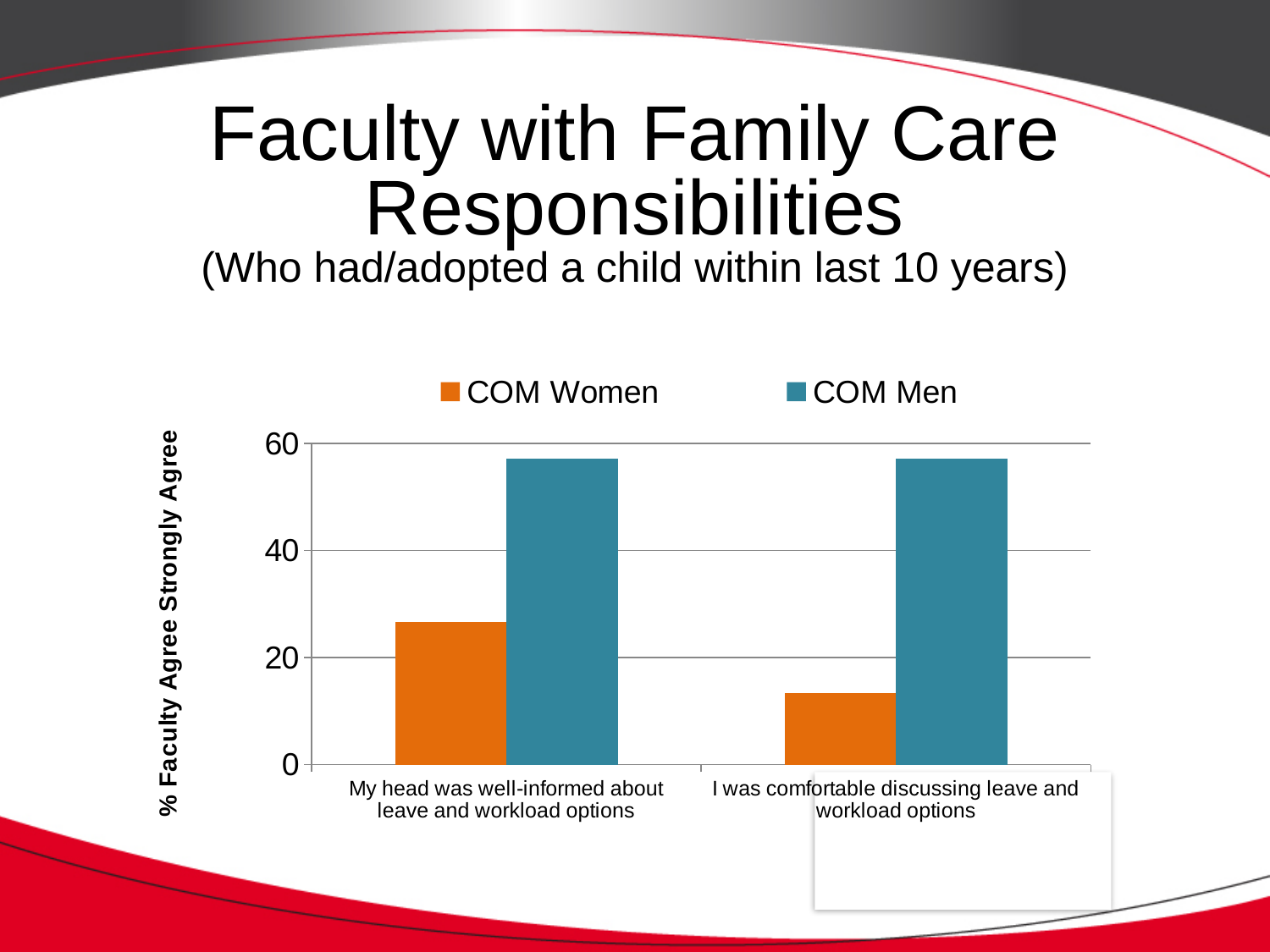
For COM Women, which category has the higher value? My head was well-informed about leave and workload options Which series has the larger value for "I was comfortable discussing leave and workload options", COM Women or COM Men? COM Men Which bar is the lowest in the chart? COM Women, I was comfortable discussing leave and workload options What kind of chart is shown on the slide? bar chart Which series has the larger value for "My head was well-informed about leave and workload options", COM Women or COM Men? COM Men What is the title of the y axis? % Faculty Agree Strongly Agree How many categories are shown on the x axis? 2 Is the COM Women value for "I was comfortable discussing leave and workload options" greater or less than 20? less Which series is shown in orange? COM Women Is the COM Men value for "My head was well-informed about leave and workload options" greater or less than 40? greater Is the COM Women value for "My head was well-informed about leave and workload options" greater or less than 20? greater How many series does the legend list? 2